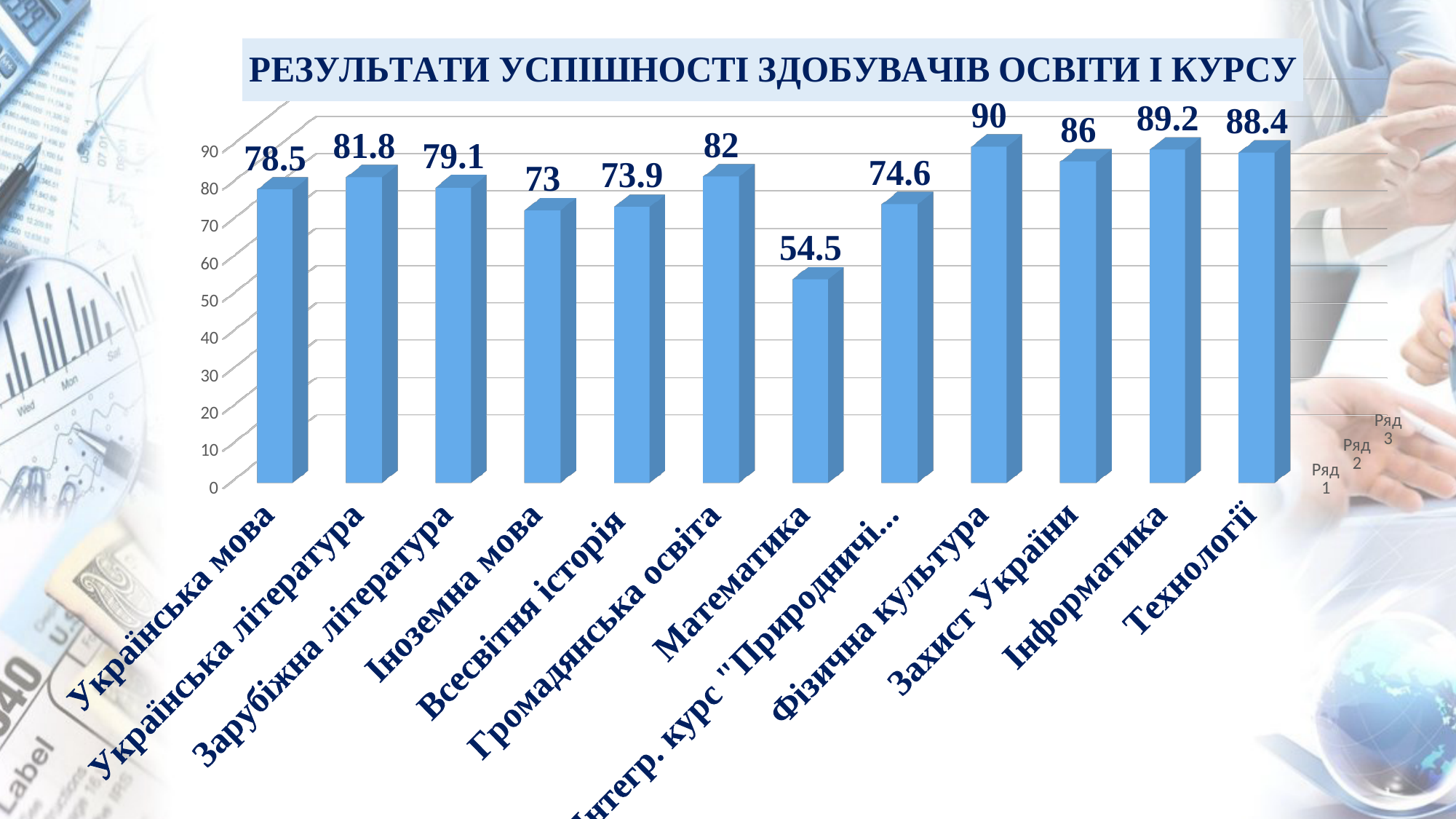
How many categories are shown on the chart? 12 What kind of chart is shown on the slide? bar chart What is the difference between the values for Захист України and Іноземна мова? 13 What is the value for Громадянська освіта? 82 Which category has the lowest value? Математика Is the value for Технології greater or less than 80? greater What is the value for Інформатика? 89.2 What is the value for Українська мова? 78.5 What is the difference between the values for Фізична культура and Математика? 35.5 Which category has the highest value? Фізична культура Which is larger, the value for Українська література or the value for Зарубіжна література? Українська література What is the value for Математика? 54.5